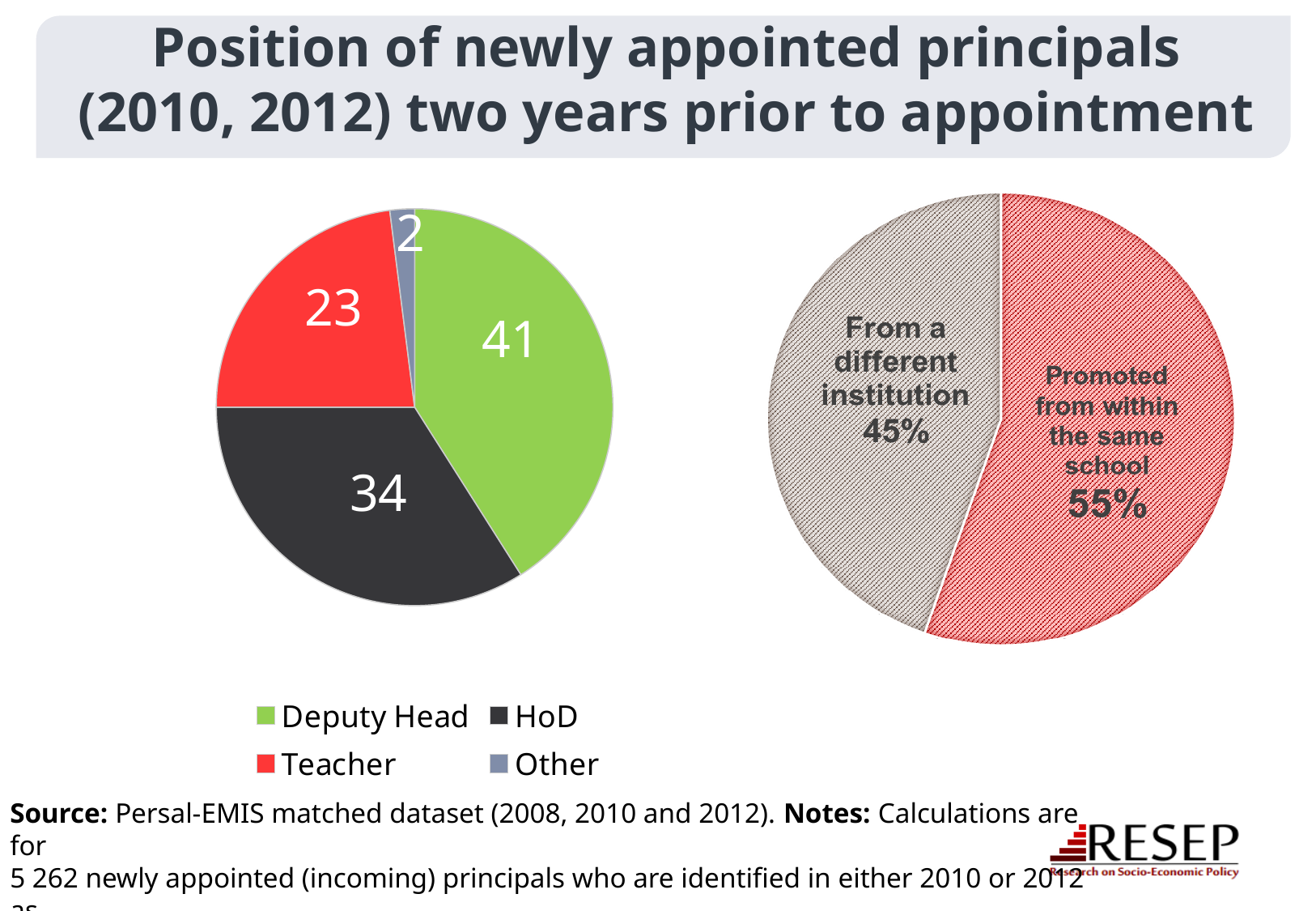
In the left pie chart, what is the difference between the values for Deputy Head and HoD? 7 In the right pie chart, what share of principals came from a different institution? 45% In the left pie chart, what is the value for Teacher? 23 In the left pie chart, which category has the smallest slice? Other In the left pie chart, which category has the largest slice? Deputy Head In the left pie chart, which colour represents Teacher? Red What type of chart is shown on the left of the slide? Pie chart In the left pie chart, what is the value for HoD? 34 In the left pie chart, what is the value for Deputy Head? 41 In the right pie chart, what share of principals were promoted from within the same school? 55% How many categories does the legend of the left pie chart list? 4 In the left pie chart, which is larger, HoD or Teacher? HoD